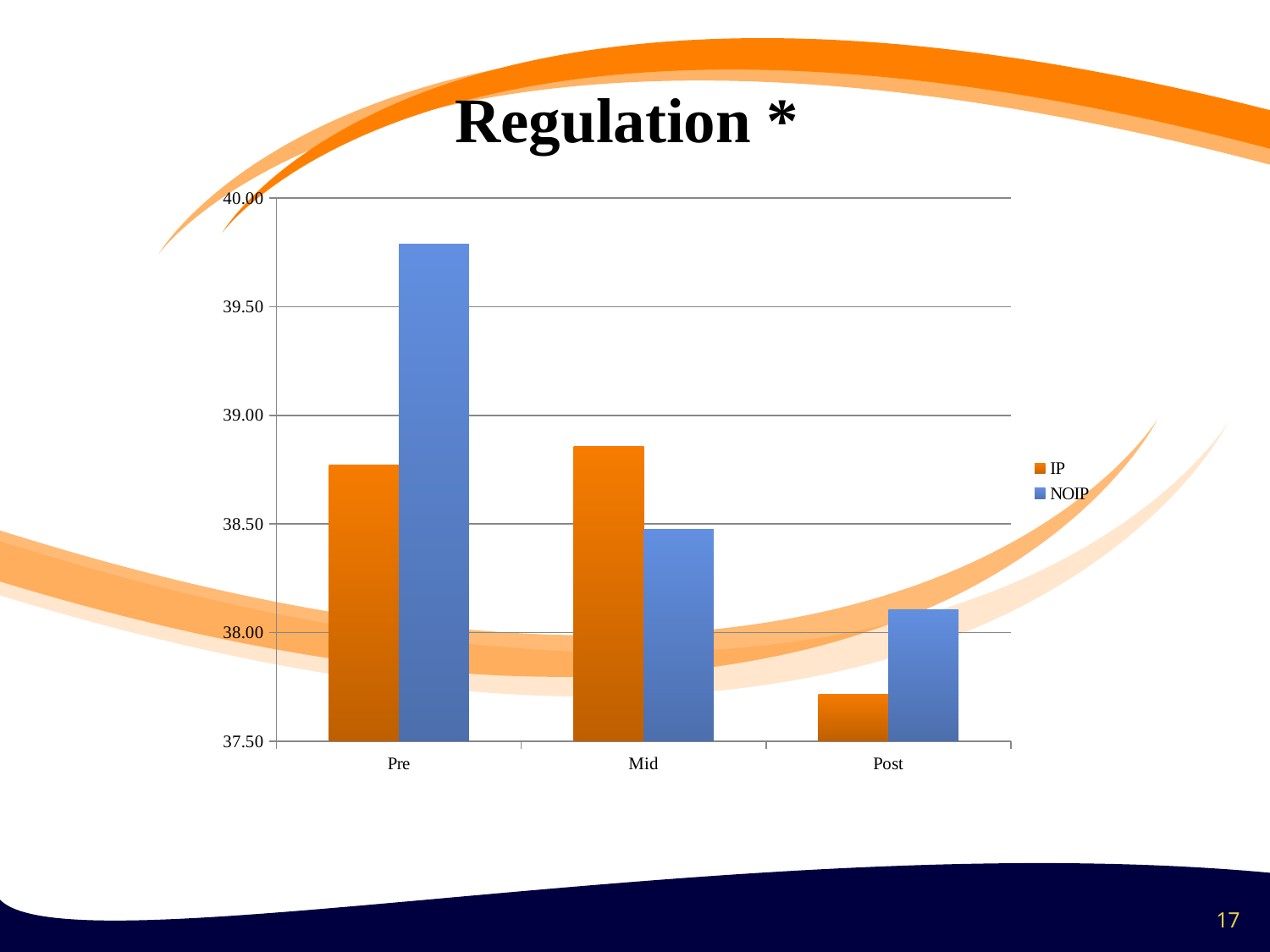
At which category is the IP value lowest? Post At which category is the NOIP value highest? Pre Is the IP value for Post greater or less than 38.00? less What kind of chart is shown on the slide? bar chart Do the NOIP values rise or fall from Pre to Post? fall At Pre, which series has the larger value, IP or NOIP? NOIP How many categories are shown on the x axis? 3 What is the title of the chart? Regulation * Is the IP value for Mid greater or less than 39.00? less At Mid, which series has the larger value, IP or NOIP? IP How many series does the legend list? 2 Is the NOIP value for Pre greater or less than 39.50? greater